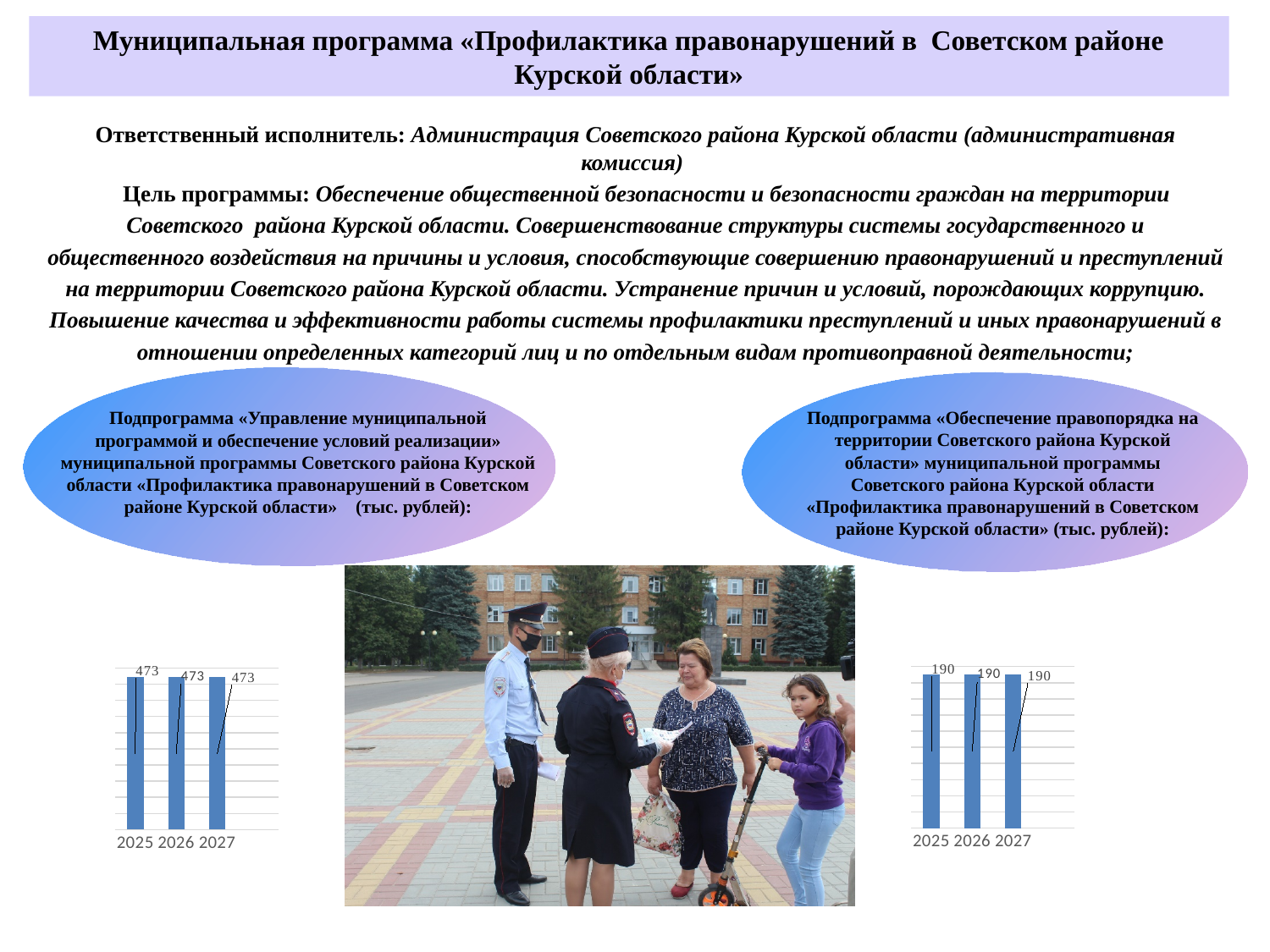
In the right chart, what is the value for 2026? 190 What kind of chart is the left chart? bar chart In the left chart, do the values rise, fall or stay the same from 2025 to 2027? stay the same In the right chart, do the values rise, fall or stay the same from 2025 to 2027? stay the same How many categories are on the x axis of the right chart? 3 What kind of chart is the right chart? bar chart In the left chart, what is the value for 2027? 473 In the right chart, what is the value for 2027? 190 In the left chart, what is the value for 2025? 473 In the left chart, what is the difference between the values for 2026 and 2025? 0 Which years are shown on the x axis of the right chart? 2025, 2026, 2027 How many bars does the left chart show? 3